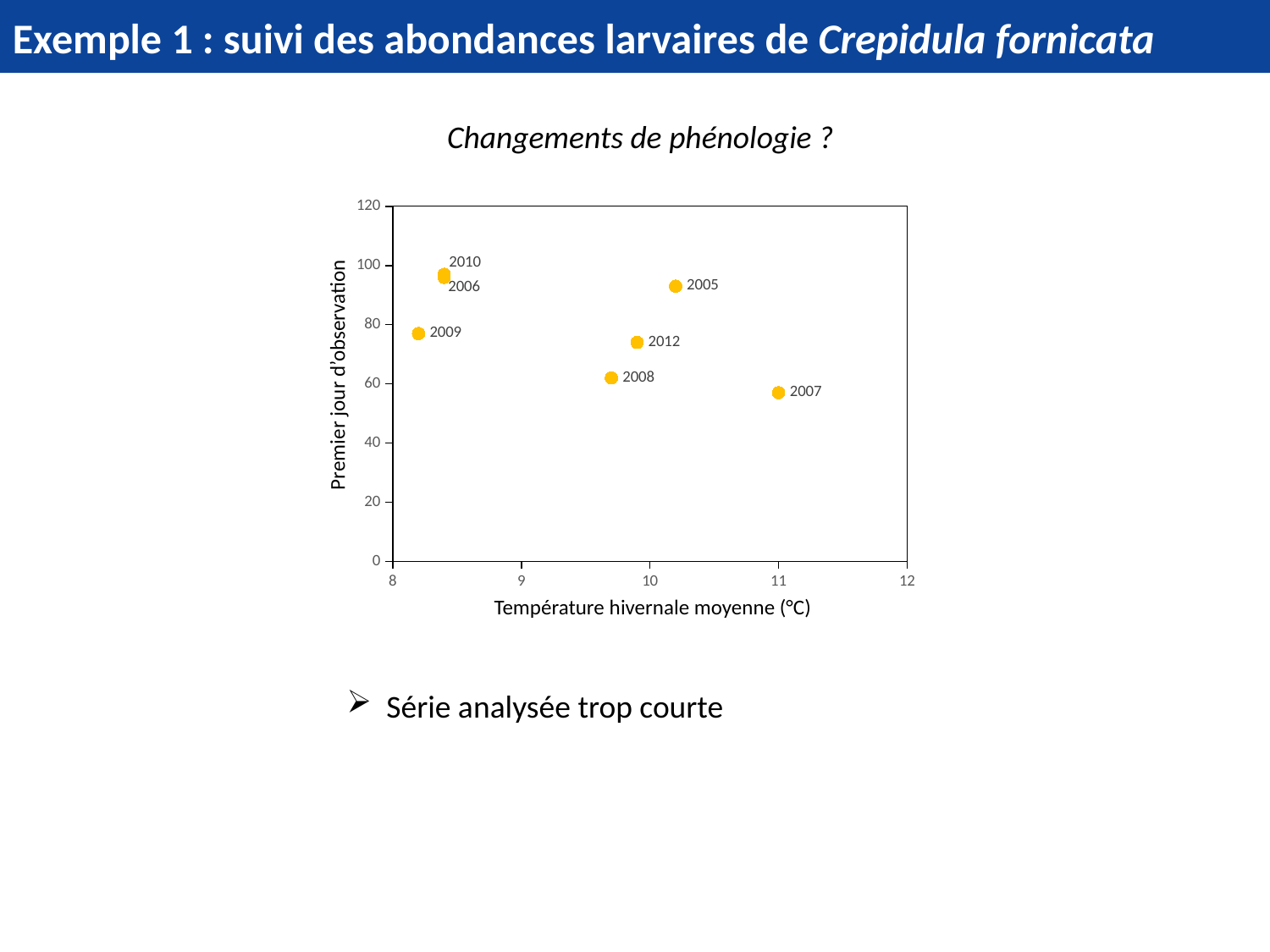
Is the Premier jour d'observation for 2009 greater or less than 80? less How many data points are plotted on the chart? 7 What is the label of the x axis of the chart? Température hivernale moyenne (°C) Is the Premier jour d'observation for 2012 greater or less than 80? less Is the Premier jour d'observation for 2010 greater or less than 80? greater Which has a higher Premier jour d'observation, 2005 or 2012? 2005 What kind of chart is shown on the slide? scatter chart Which has a higher Premier jour d'observation, 2009 or 2008? 2009 Which year has the lowest value for Premier jour d'observation? 2007